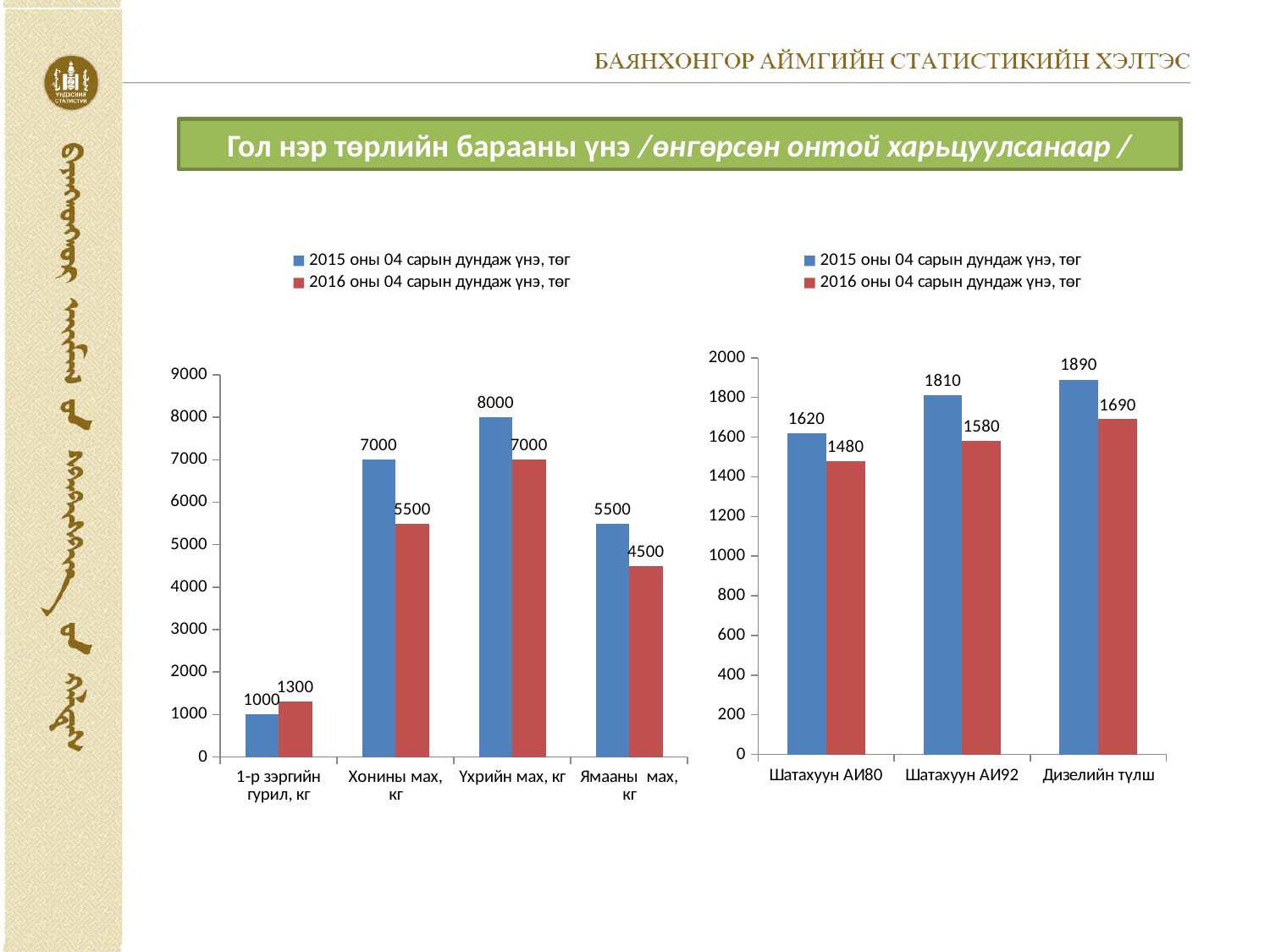
How many categories are shown in the right chart? 3 In the right chart, what is the 2016 оны 04 сарын дундаж үнэ for Шатахуун АИ92? 1580 In the left chart, what is the difference between the 2015 and 2016 values for Ямааны мах, кг? 1000 In the left chart, which is larger for 1-р зэргийн гурил, кг: the 2015 value or the 2016 value? 2016 value How many series does the legend of the left chart list? 2 In the right chart, do the 2016 оны 04 сарын дундаж үнэ values rise or fall from Шатахуун АИ80 to Дизелийн түлш? Rise In the left chart, what is the 2015 оны 04 сарын дундаж үнэ for Үхрийн мах, кг? 8000 In the right chart, which category has the highest 2015 оны 04 сарын дундаж үнэ? Дизелийн түлш What type of chart is the right chart? Bar chart In the left chart, which category has the lowest 2016 оны 04 сарын дундаж үнэ? 1-р зэргийн гурил, кг In the right chart, what is the difference between the 2015 and 2016 values for Шатахуун АИ80? 140 In the left chart, what is the 2016 оны 04 сарын дундаж үнэ for Хонины мах, кг? 5500